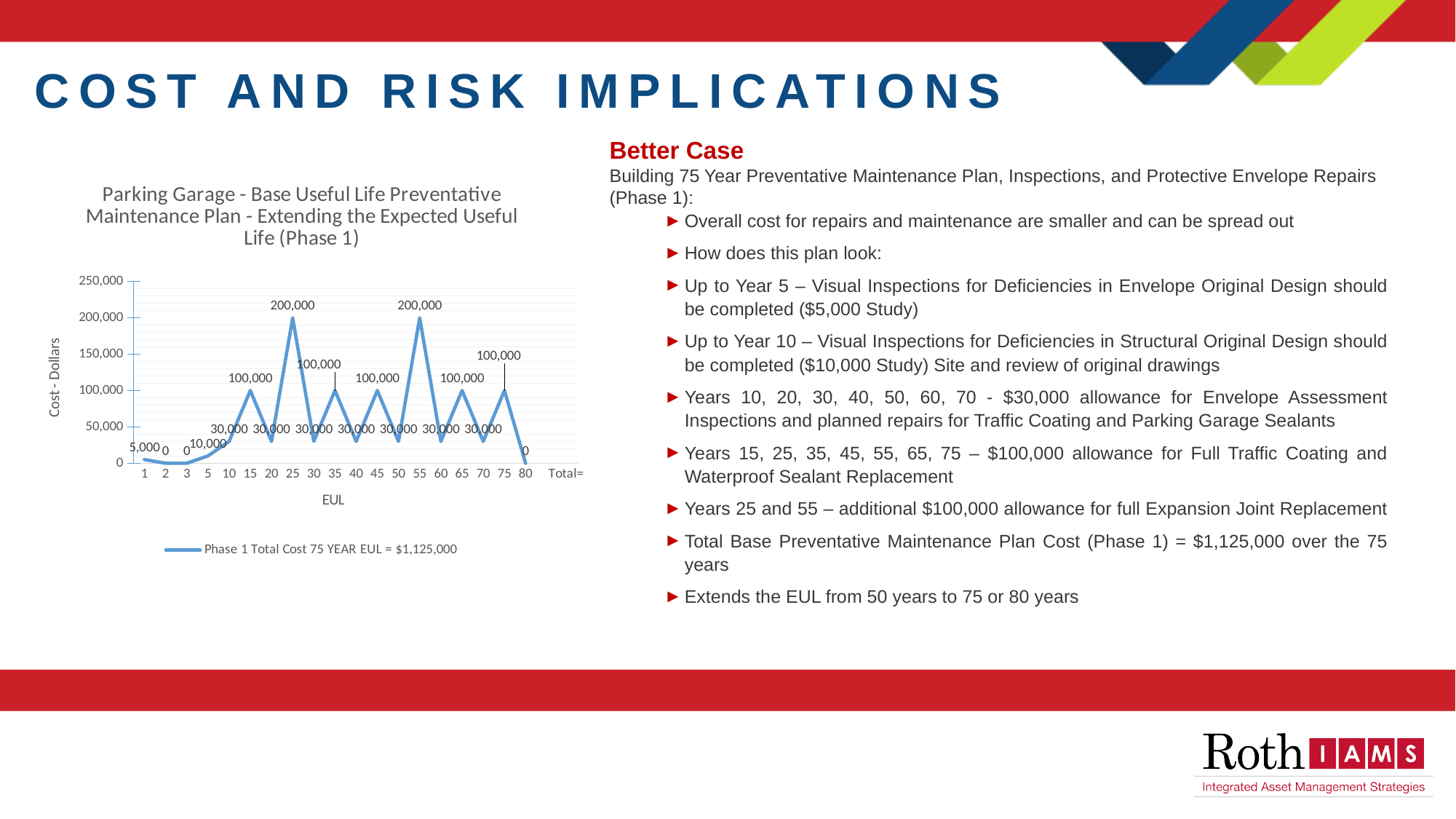
What is the label of the y-axis on the chart? Cost - Dollars What is the cost value plotted at EUL year 1? 5,000 Is the cost value at year 55 greater or less than 150,000? greater What is the cost value plotted at EUL year 15? 100,000 Which is larger, the cost at year 35 or the cost at year 40? Year 35 What is the highest cost value plotted on the chart? 200,000 How many series does the legend list? 1 What is the cost value plotted at EUL year 80? 0 What is the difference between the cost at year 25 and the cost at year 20? 170,000 What is the cost value plotted at EUL year 5? 10,000 What is the cost value plotted at EUL year 25? 200,000 What kind of chart is shown on the slide? Line chart